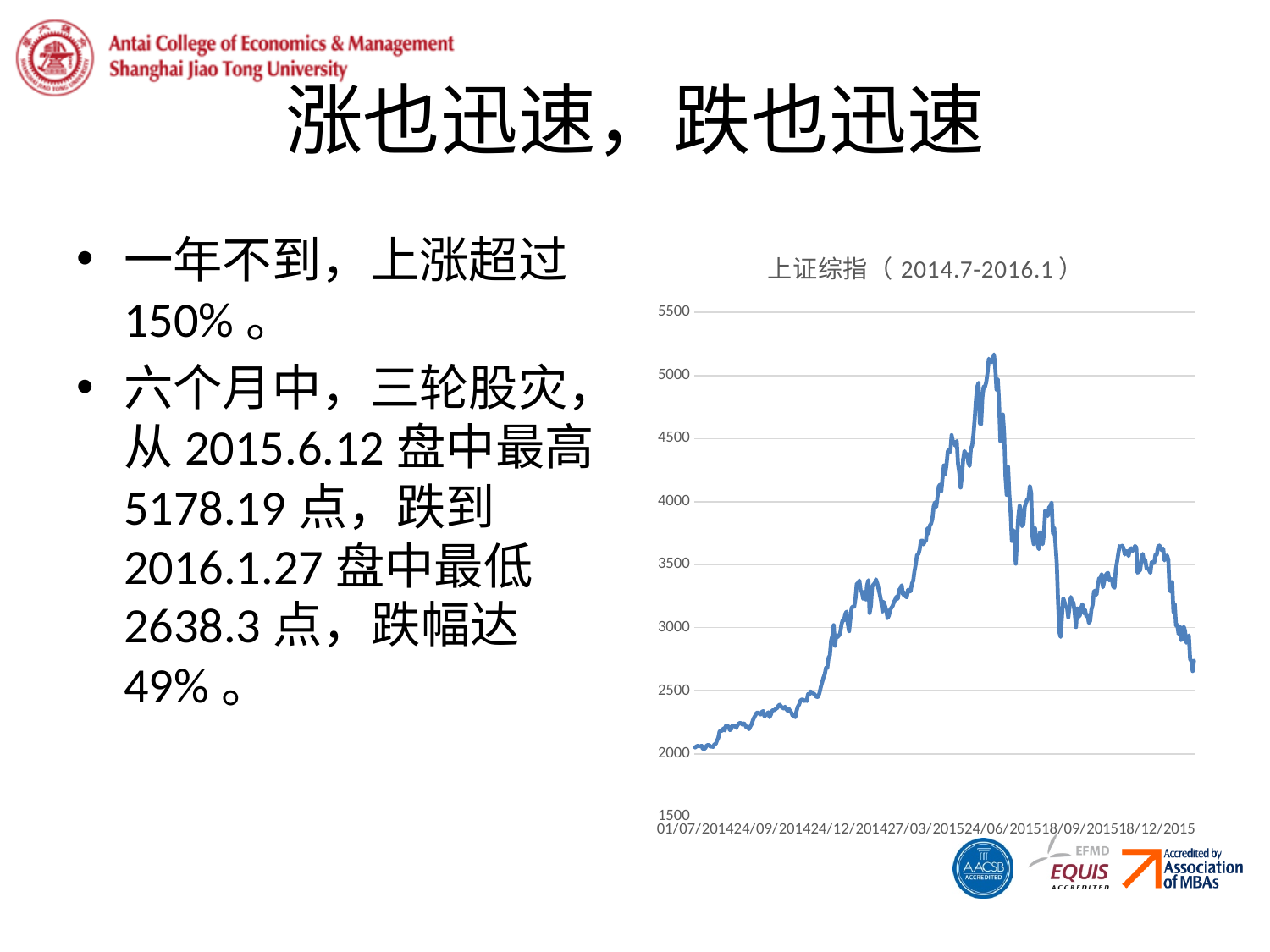
What is the highest value shown on the chart's vertical axis? 5500 Is the value at 18/09/2015 greater or less than 3500? less Is the peak value of the line greater or less than 5000? greater From its peak in mid-2015 to the end of the series, does the line rise or fall overall? fall Is the value at 27/03/2015 greater or less than 3500? greater How many date labels are shown on the horizontal axis? 7 What kind of chart is shown on the slide? line chart Between 01/07/2014 and 27/03/2015, does the line rise or fall? rise What is the title of the chart? 上证综指（2014.7-2016.1）